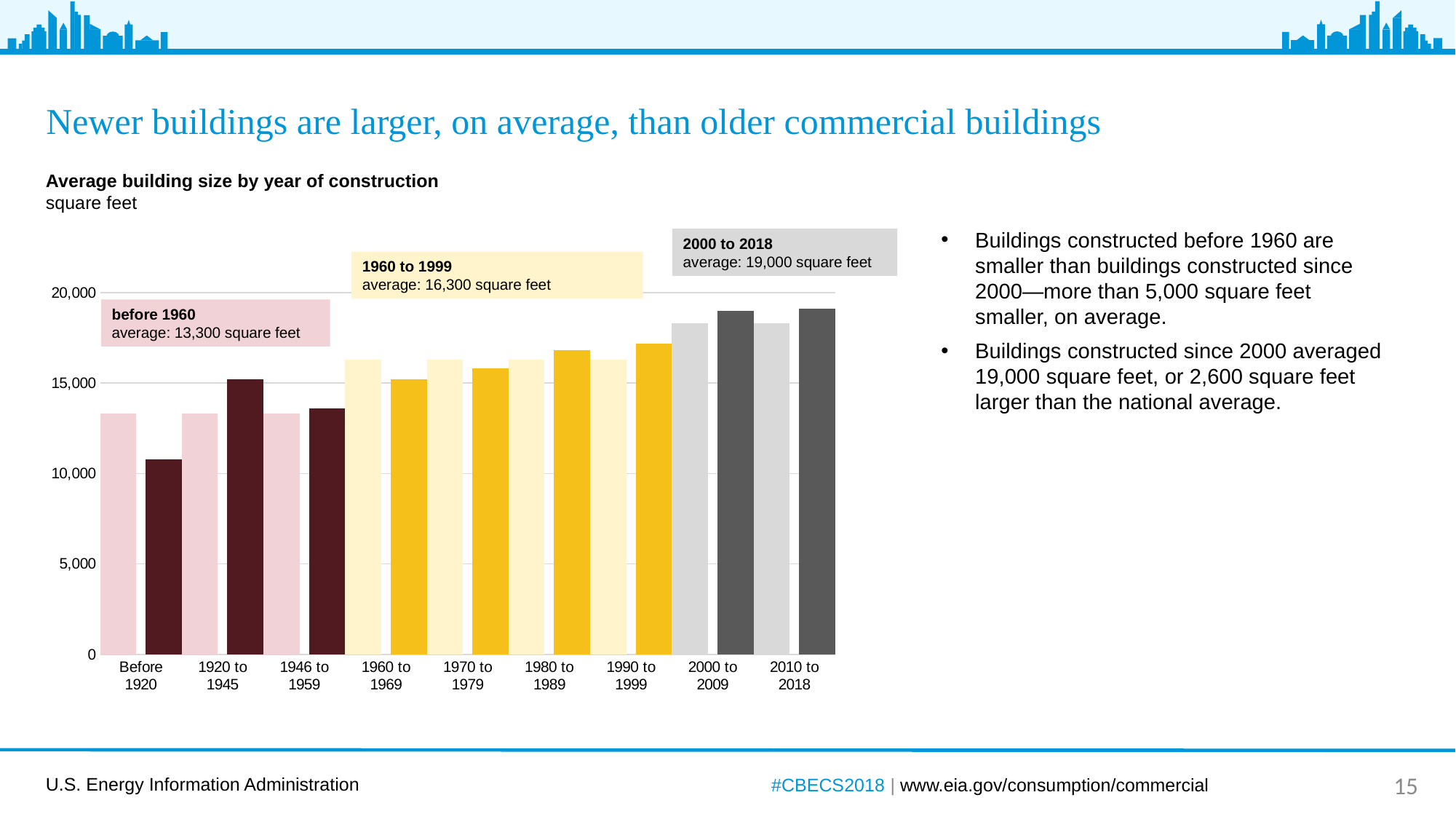
Which construction period has the lowest average building size? Before 1920 According to the chart annotation, what is the average building size for buildings constructed 1960 to 1999? 16,300 square feet Which is larger, the value for 1946 to 1959 or the value for 1990 to 1999? 1990 to 1999 How many construction-period categories are shown on the x axis of the chart? 9 What is the title of the chart? Average building size by year of construction What kind of chart is shown on the slide? bar chart How much larger is the 2000 to 2018 group average than the before 1960 group average? 5,700 square feet According to the chart annotation, what is the average building size for buildings constructed before 1960? 13,300 square feet What unit is the chart's vertical axis measured in? square feet Is the value for Before 1920 greater or less than 15,000? less Do the average building sizes generally rise or fall from the oldest to the newest construction period? rise According to the chart annotation, what is the average building size for buildings constructed 2000 to 2018? 19,000 square feet